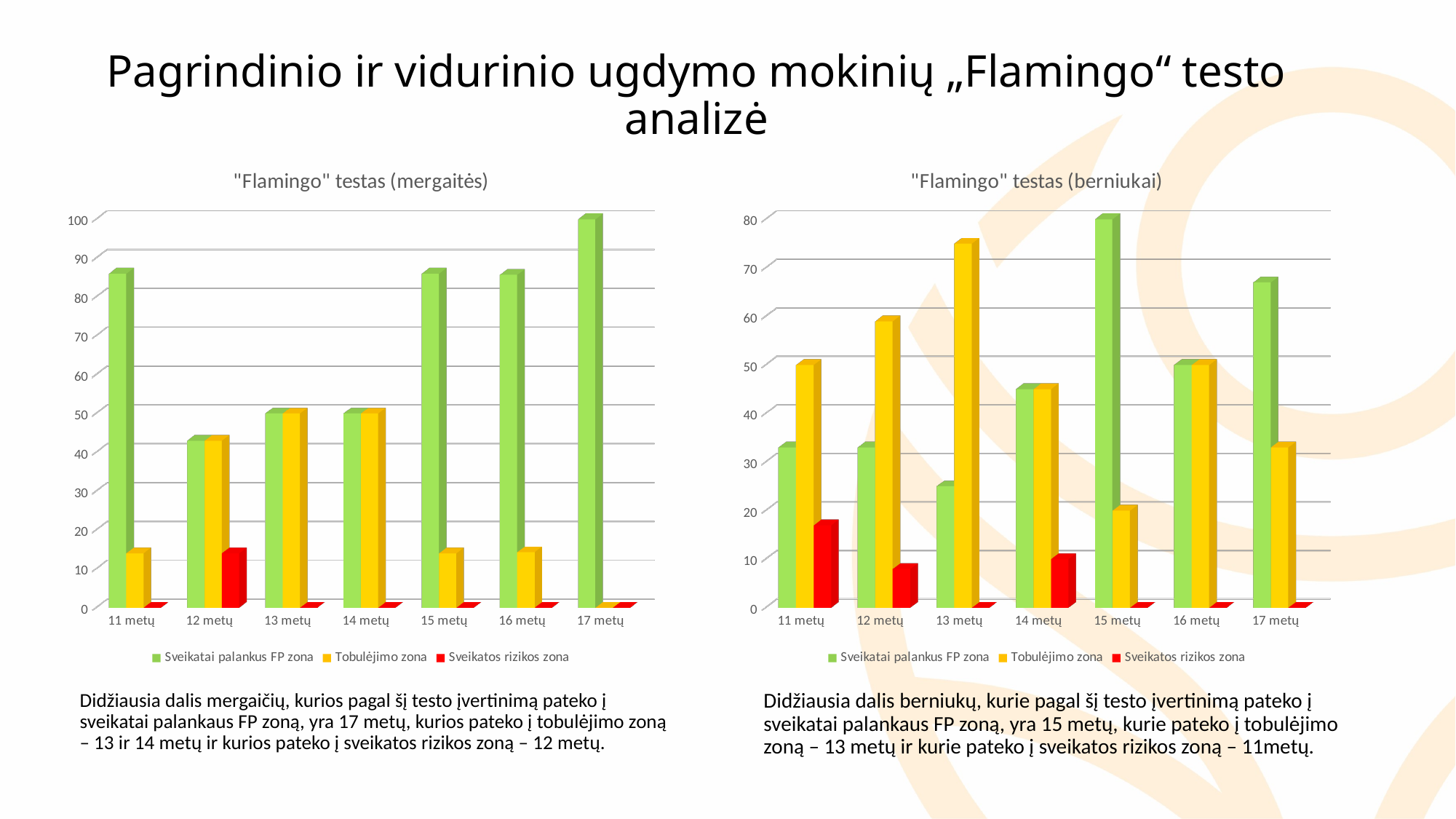
In the "Flamingo" testas (berniukai) chart, what is the Sveikatai palankus FP zona value for 15 metų? 80 How many series does the legend of the "Flamingo" testas (mergaitės) chart list? 3 What kind of chart is the "Flamingo" testas (mergaitės) chart? bar chart In the "Flamingo" testas (mergaitės) chart, which age group has the highest Sveikatai palankus FP zona value? 17 metų In the "Flamingo" testas (mergaitės) chart, is the Sveikatai palankus FP zona value for 11 metų greater or less than 80? greater In the "Flamingo" testas (berniukai) chart, which age group has the highest Tobulėjimo zona value? 13 metų How many age groups are shown on the x axis of the "Flamingo" testas (berniukai) chart? 7 In the "Flamingo" testas (berniukai) chart, which age group has the highest Sveikatos rizikos zona value? 11 metų In the "Flamingo" testas (berniukai) chart, which is larger for 12 metų: Sveikatai palankus FP zona or Tobulėjimo zona? Tobulėjimo zona In the "Flamingo" testas (mergaitės) chart, what is the Sveikatai palankus FP zona value for 17 metų? 100